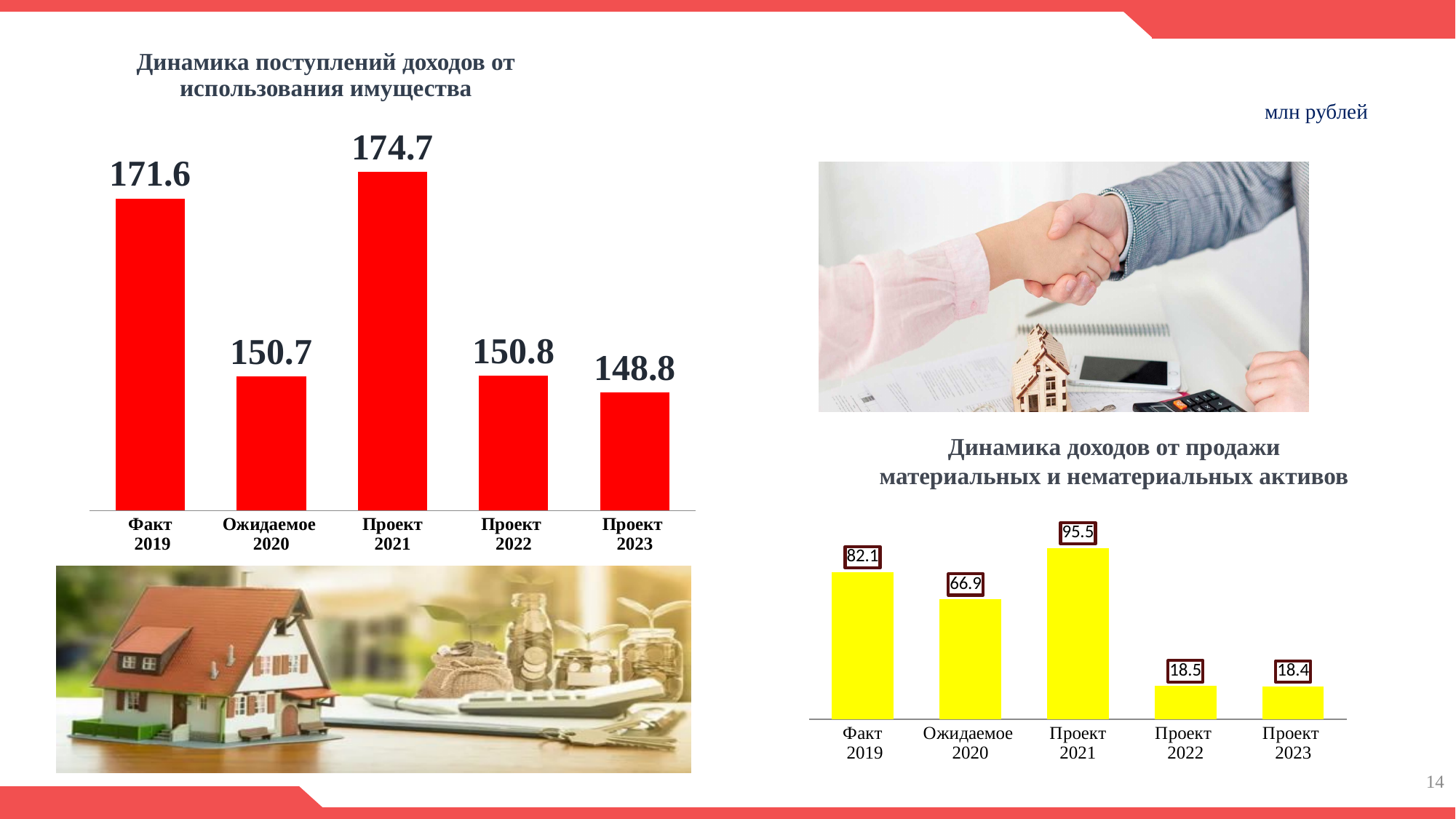
In the chart 'Динамика поступлений доходов от использования имущества', what is the value for Факт 2019? 171.6 In the chart 'Динамика доходов от продажи материальных и нематериальных активов', what is the value for Проект 2021? 95.5 What colour are the bars in the chart 'Динамика доходов от продажи материальных и нематериальных активов'? yellow In the chart 'Динамика поступлений доходов от использования имущества', which category has the lowest value? Проект 2023 How many categories are shown in the chart 'Динамика поступлений доходов от использования имущества'? 5 What type of chart is 'Динамика доходов от продажи материальных и нематериальных активов'? bar chart In the chart 'Динамика поступлений доходов от использования имущества', which is larger: the value for Факт 2019 or the value for Ожидаемое 2020? Факт 2019 In the chart 'Динамика доходов от продажи материальных и нематериальных активов', what is the difference between the values for Факт 2019 and Проект 2022? 63.6 In the chart 'Динамика поступлений доходов от использования имущества', which category has the highest value? Проект 2021 In the chart 'Динамика доходов от продажи материальных и нематериальных активов', which category has the highest value? Проект 2021 In the chart 'Динамика доходов от продажи материальных и нематериальных активов', what is the value for Ожидаемое 2020? 66.9 In the chart 'Динамика поступлений доходов от использования имущества', what is the difference between the values for Проект 2021 and Факт 2019? 3.1